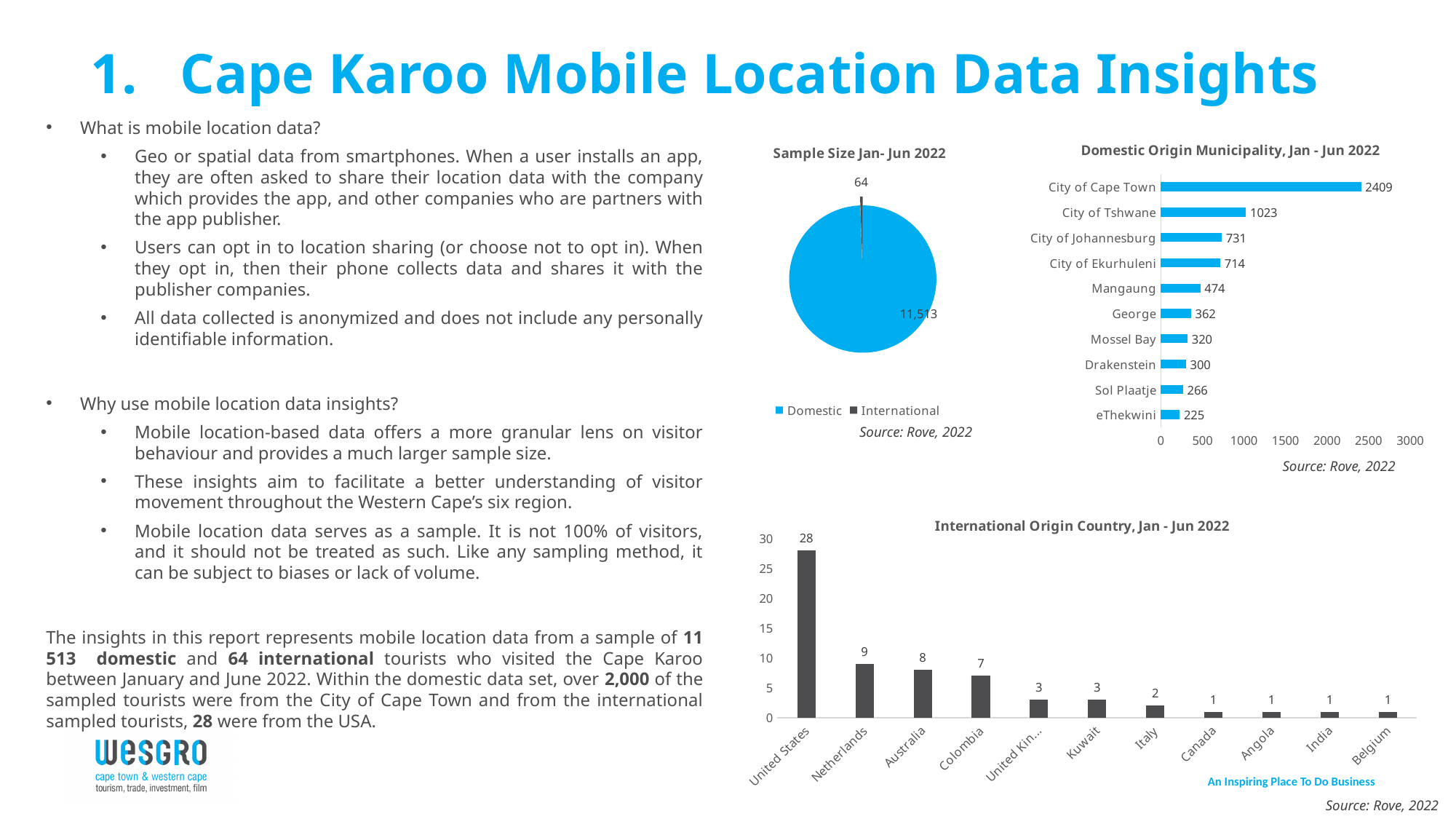
In the 'International Origin Country, Jan - Jun 2022' chart, which country has the highest value? United States In the 'Domestic Origin Municipality, Jan - Jun 2022' chart, what is the difference between City of Cape Town and City of Tshwane? 1386 In the 'International Origin Country, Jan - Jun 2022' chart, which is larger, Australia or Colombia? Australia In the 'Domestic Origin Municipality, Jan - Jun 2022' chart, which municipality has the highest value? City of Cape Town How many municipalities are shown in the 'Domestic Origin Municipality, Jan - Jun 2022' chart? 10 In the 'International Origin Country, Jan - Jun 2022' chart, what is the value for Netherlands? 9 In the 'Sample Size Jan- Jun 2022' chart, what is the value for International? 64 In the 'Sample Size Jan- Jun 2022' chart, what is the value for Domestic? 11,513 What kind of chart is the 'International Origin Country, Jan - Jun 2022' chart? Bar chart What kind of chart is the 'Sample Size Jan- Jun 2022' chart? Pie chart In the 'Domestic Origin Municipality, Jan - Jun 2022' chart, which municipality has the lowest value? eThekwini In the 'Domestic Origin Municipality, Jan - Jun 2022' chart, what is the value for City of Tshwane? 1023